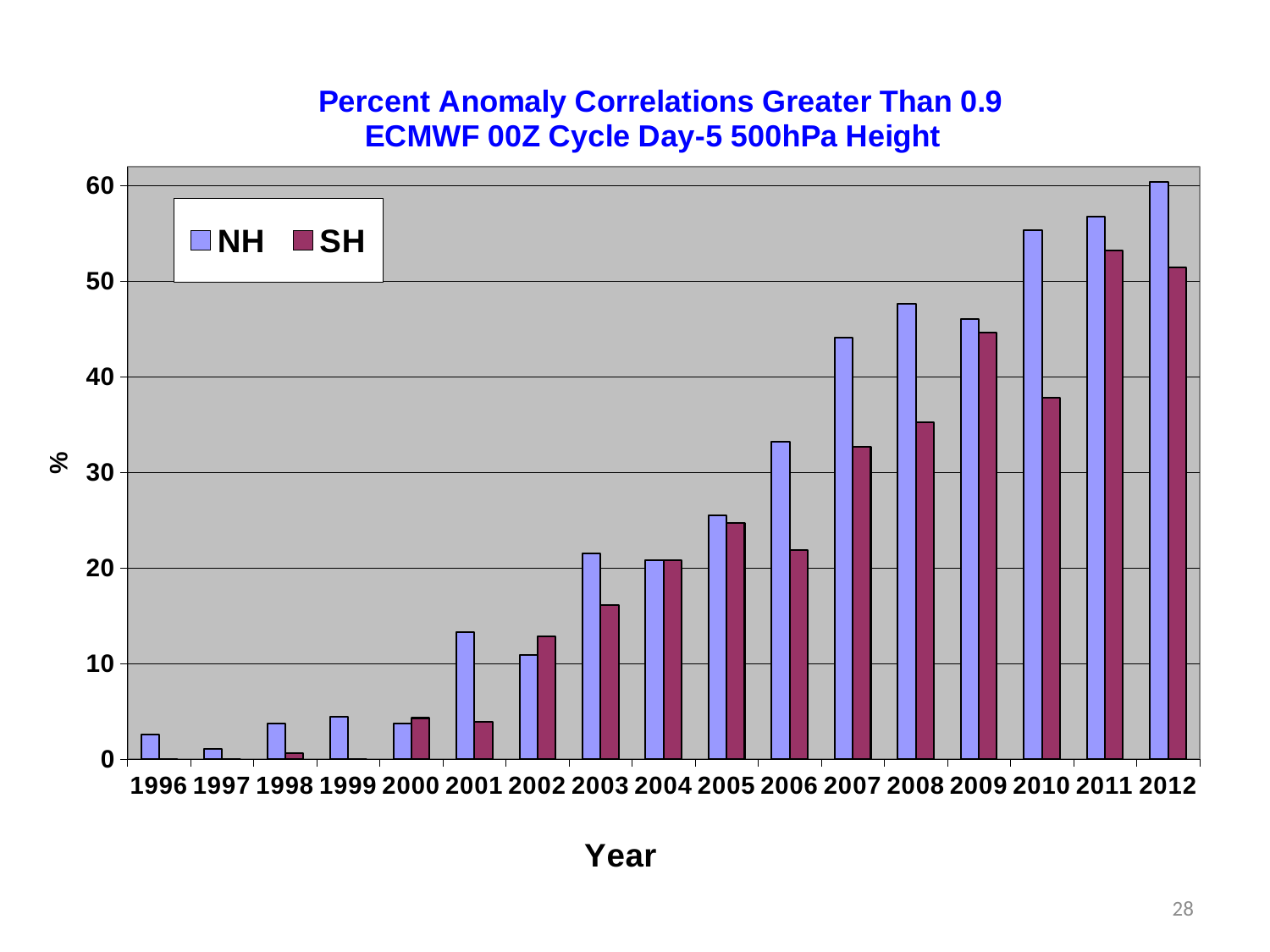
Is the NH value for 2010 greater or less than 50? greater In which year is the NH value lowest? 1997 Is the NH value for 2006 greater or less than 30? greater In 2010, which series has the larger value, NH or SH? NH In which year is the NH value highest? 2012 What kind of chart is shown on the slide? bar chart In which year is the SH value highest? 2011 Is the SH value for 2010 greater or less than 40? less How many years are shown along the x axis? 17 How many series does the legend list? 2 Overall, do the NH values rise or fall from 1996 to 2012? rise In 2002, which series has the larger value, NH or SH? SH